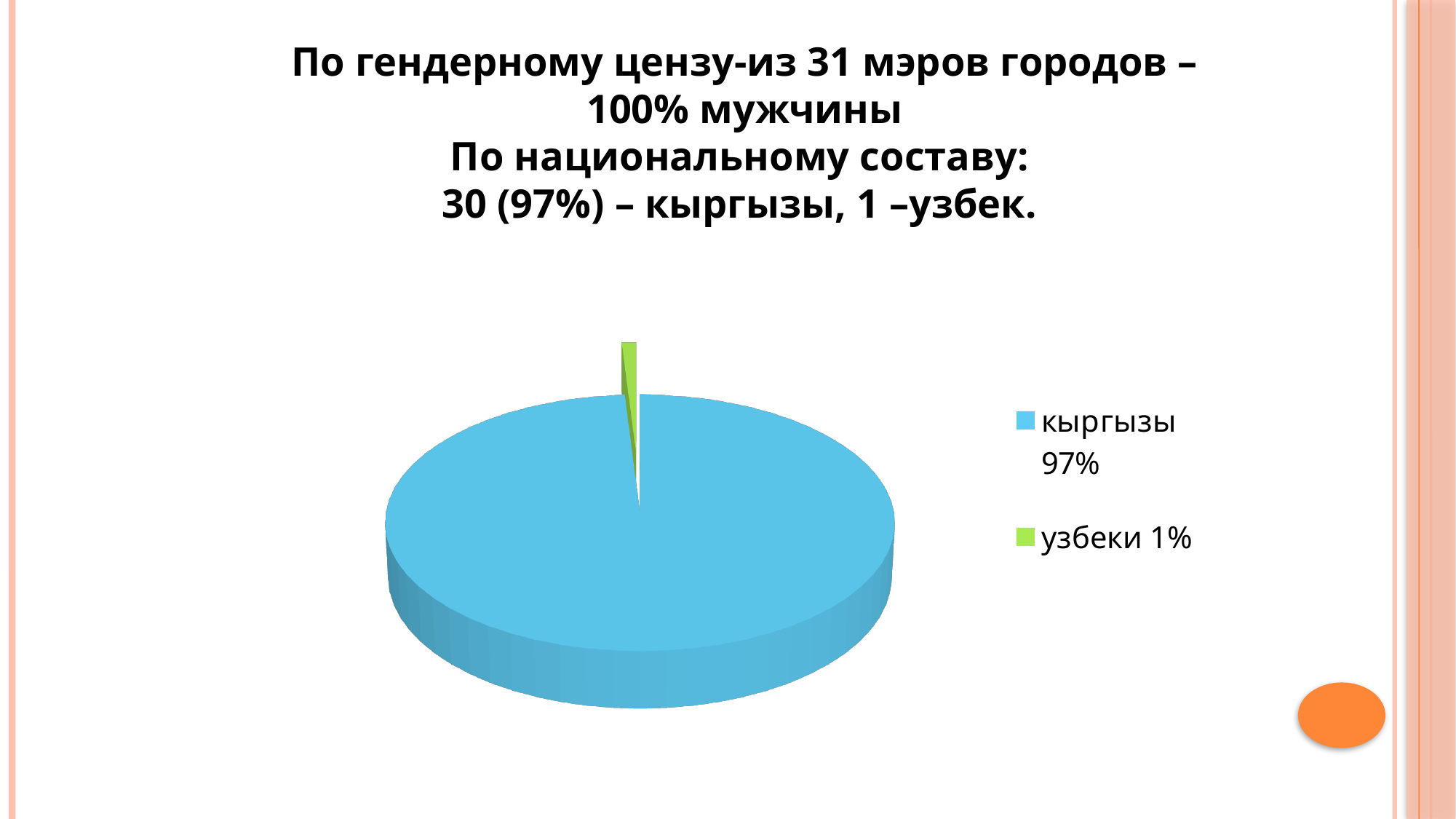
What kind of chart is shown on the slide? pie chart What colour is the slice for узбеки in the pie chart? green What share of the pie does the slice for кыргызы represent? 97% What is the difference in percentage points between the кыргызы slice and the узбеки slice? 96% Which slice of the pie chart is the largest? кыргызы How many slices does the pie chart have? 2 What colour is the slice for кыргызы in the pie chart? blue What share of the pie does the slice for узбеки represent? 1% Which slice is larger, кыргызы or узбеки? кыргызы Which slice of the pie chart is the smallest? узбеки How many entries does the legend of the pie chart list? 2